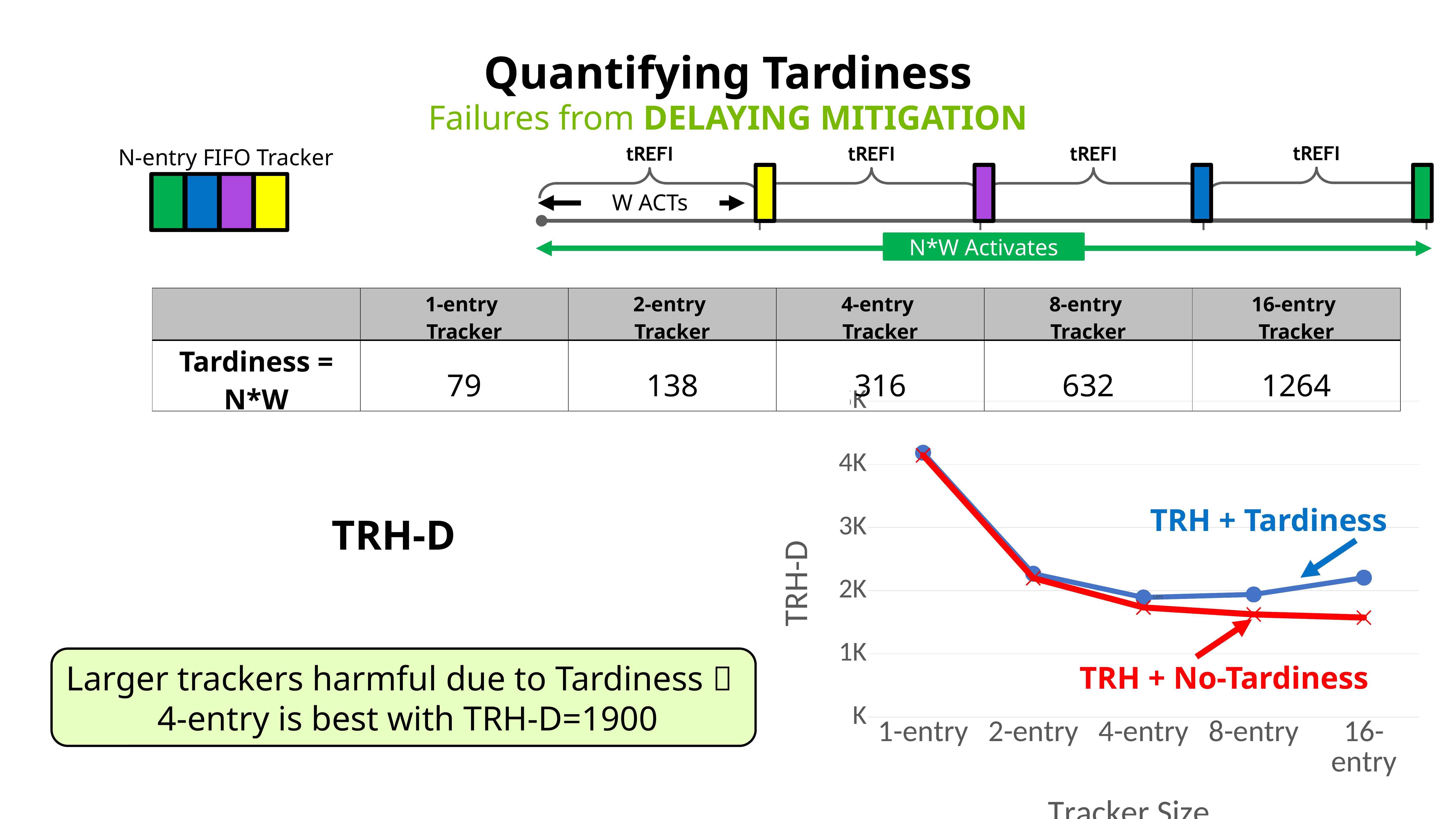
How many series are plotted in the chart? 2 What is the label of the y axis of the chart? TRH-D At 16-entry, which series has the higher TRH-D value, TRH + Tardiness or TRH + No-Tardiness? TRH + Tardiness What kind of chart is shown on the slide? line chart How many tracker sizes are plotted along the x axis of the chart? 5 Is the value for TRH + No-Tardiness at 8-entry greater or less than 2K? less Does the TRH + No-Tardiness series rise or fall as tracker size increases along the x axis? falls Is the value for TRH + Tardiness at 1-entry greater or less than 3K? greater Is the value for TRH + Tardiness at 16-entry greater or less than 2K? greater What colour is the TRH + No-Tardiness line in the chart? red For the TRH + Tardiness series, which tracker size has the highest TRH-D value? 1-entry